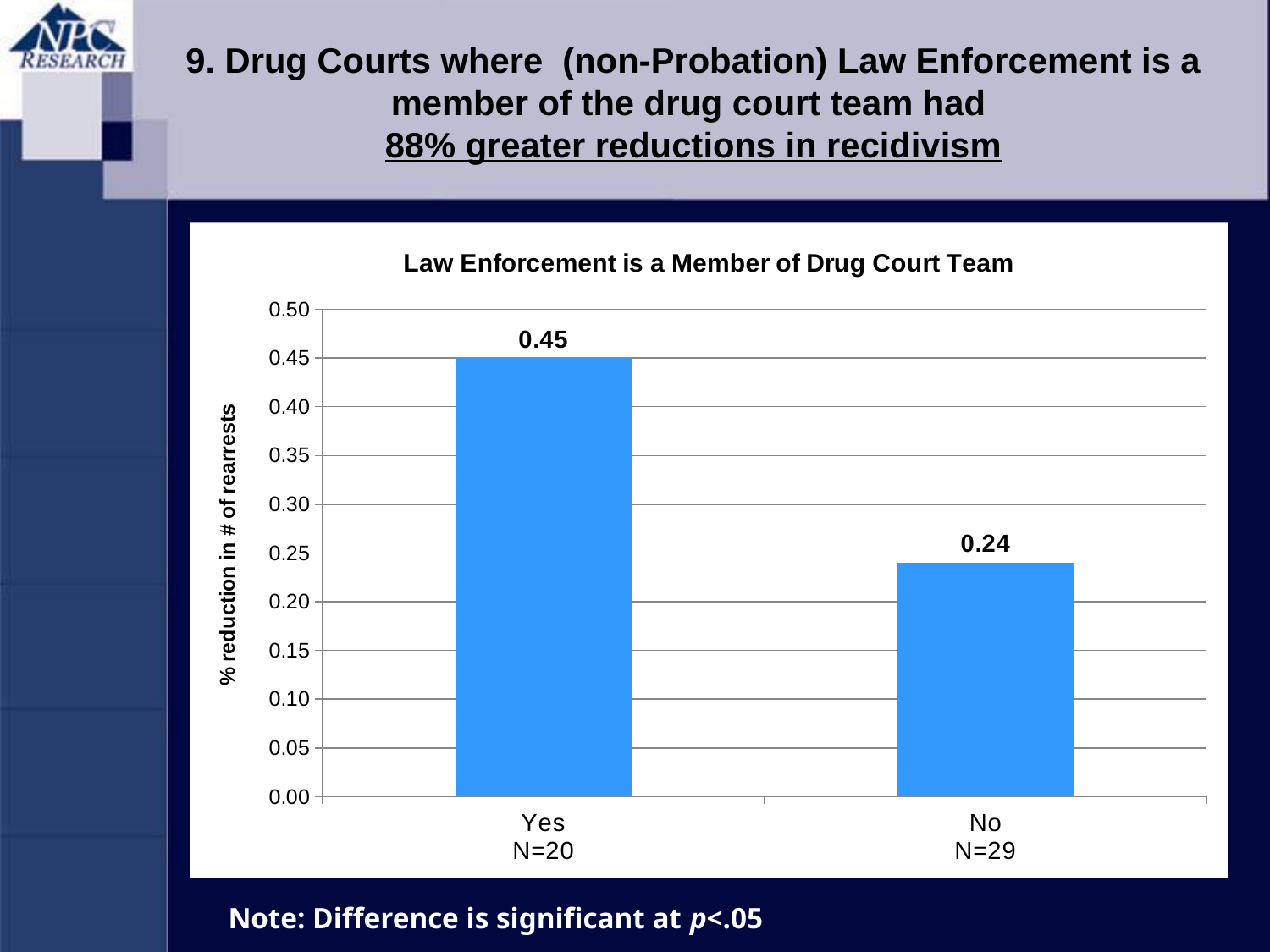
What is the label of the y axis? % reduction in # of rearrests What is the title of the chart? Law Enforcement is a Member of Drug Court Team Is the value for "No" greater or less than 0.30? less What is the value for the "Yes" category? 0.45 What is the value for the "No" category? 0.24 Which category has the highest value? Yes How many categories are shown on the x axis? 2 Which is larger, the value for "Yes" or the value for "No"? Yes What kind of chart is shown on the slide? bar chart Is the value for "Yes" greater or less than 0.40? greater Which category has the lowest value? No What is the difference between the values for "Yes" and "No"? 0.21